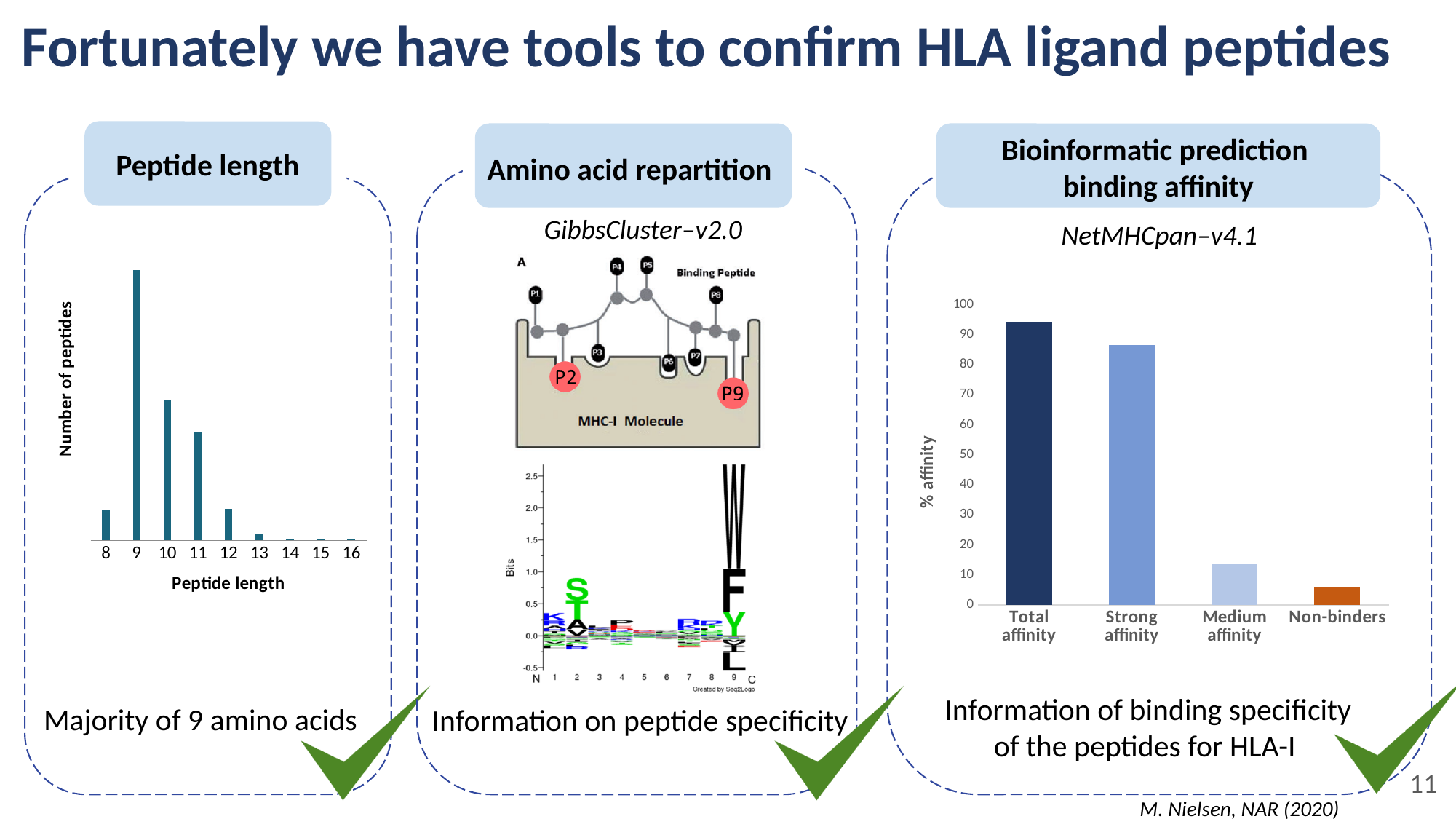
On the Bioinformatic prediction binding affinity chart, which category has the lowest % affinity? Non-binders On the Bioinformatic prediction binding affinity chart, how many categories are shown on the x axis? 4 On the Peptide length chart, do the values rise or fall from peptide length 9 to 16? fall On the Bioinformatic prediction binding affinity chart, which category has the highest % affinity? Total affinity On the Bioinformatic prediction binding affinity chart, is the value for Total affinity greater or less than 90? greater On the Bioinformatic prediction binding affinity chart, is the value for Non-binders greater or less than 10? less On the Peptide length chart, how many peptide length categories are shown on the x axis? 9 On the Bioinformatic prediction binding affinity chart, is the value for Medium affinity greater or less than 20? less On the Peptide length chart, which has more peptides, length 10 or length 12? 10 What kind of chart is the Peptide length chart? bar chart What is the y-axis label of the Bioinformatic prediction binding affinity chart? % affinity On the Peptide length chart, which peptide length has the highest number of peptides? 9